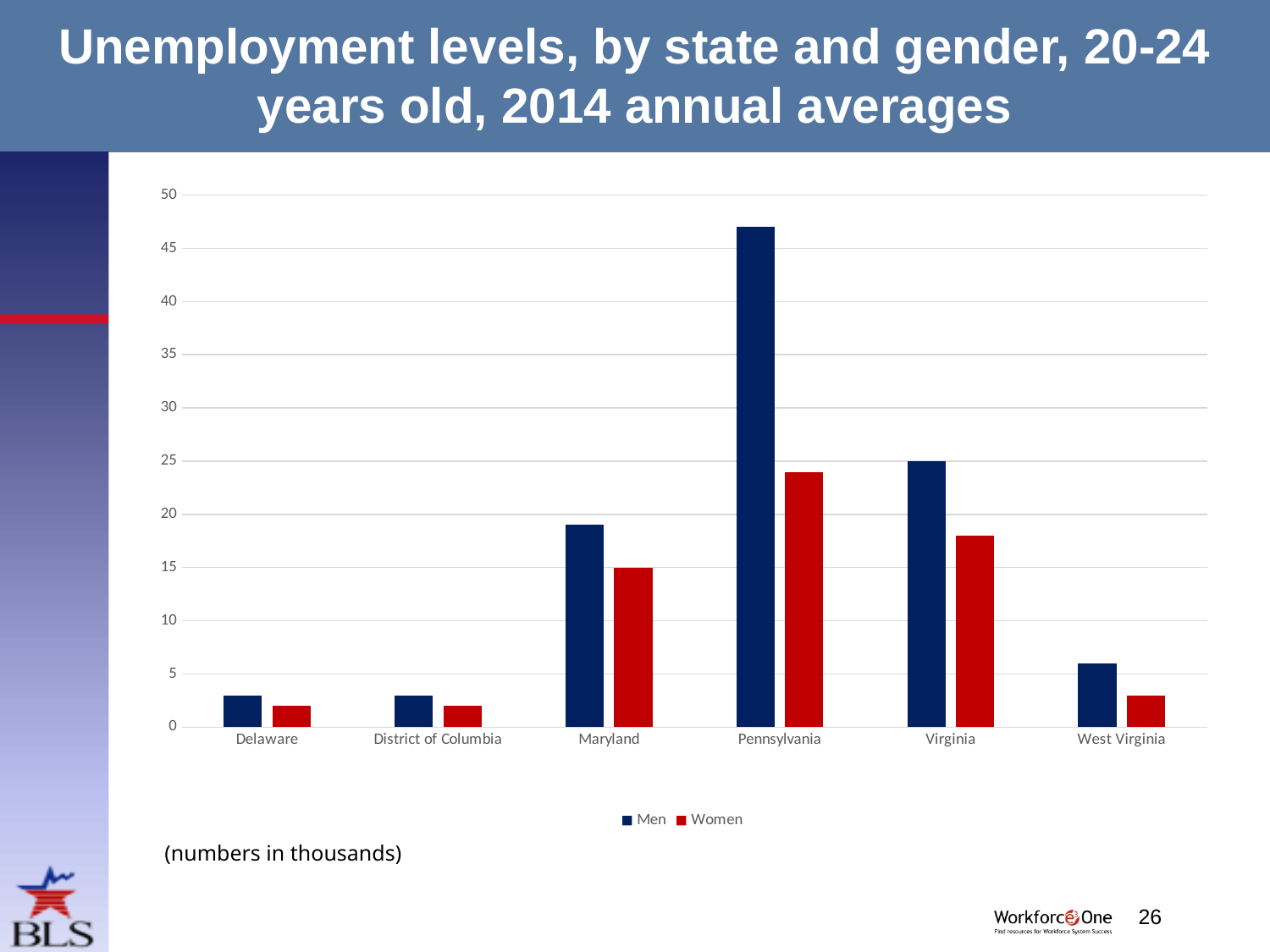
What kind of chart is shown on the slide? Bar chart Is the value for Women in Virginia greater or less than 20? less Is the value for Women in Pennsylvania greater or less than 20? greater How many series does the legend list? 2 Is the value for Men in Pennsylvania greater or less than 45? greater Which is larger, the value for Men in Virginia or the value for Men in Maryland? Virginia How many states (categories) are shown on the x axis? 6 Which state has the highest unemployment level for Men? Pennsylvania In Pennsylvania, which is larger, the value for Men or the value for Women? Men What colour represents the Women series in the legend? Red Which state has the highest unemployment level for Women? Pennsylvania